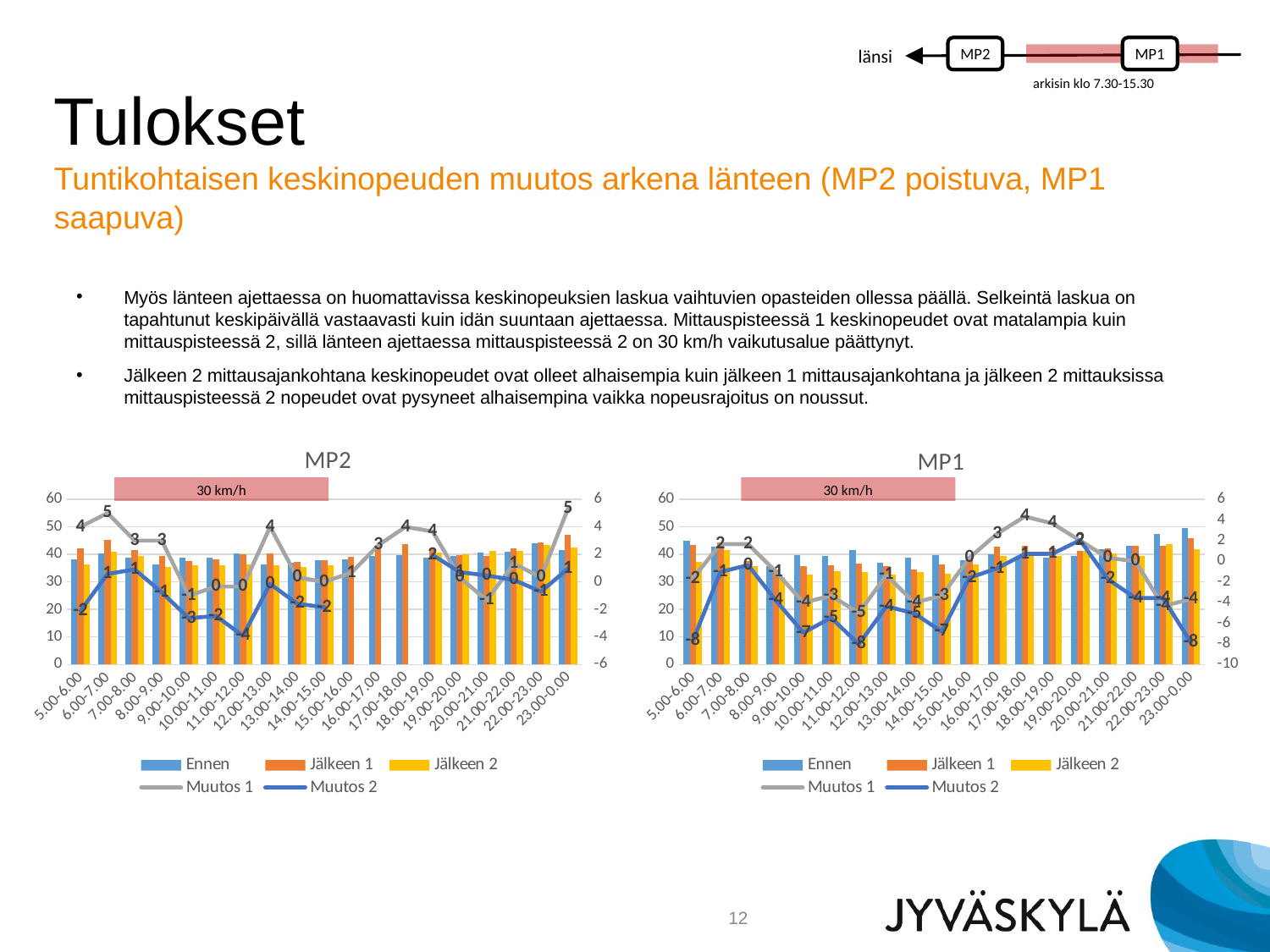
On the MP2 chart, is the Ennen value for 6.00-7.00 greater or less than 30? greater What speed limit is shown in the red band above both charts? 30 km/h On the MP1 chart, what is the value of Muutos 2 at 23.00-0.00? -8 On the MP2 chart, what is the value of Muutos 1 at 6.00-7.00? 5 What kind of chart is the MP2 chart? Combined bar and line chart On the MP1 chart, what is the value of Muutos 2 at 5.00-6.00? -8 On the MP2 chart, which time slot has the lowest Muutos 2 value? 11.00-12.00 How many time-slot categories are shown on the x axis of the MP2 chart? 19 On the MP2 chart, what is the value of Muutos 2 at 5.00-6.00? -2 On the MP1 chart, what is the value of Muutos 1 at 17.00-18.00? 4 On the MP2 chart, what is the value of Muutos 2 at 12.00-13.00? 0 How many series does the legend of the MP1 chart list? 5